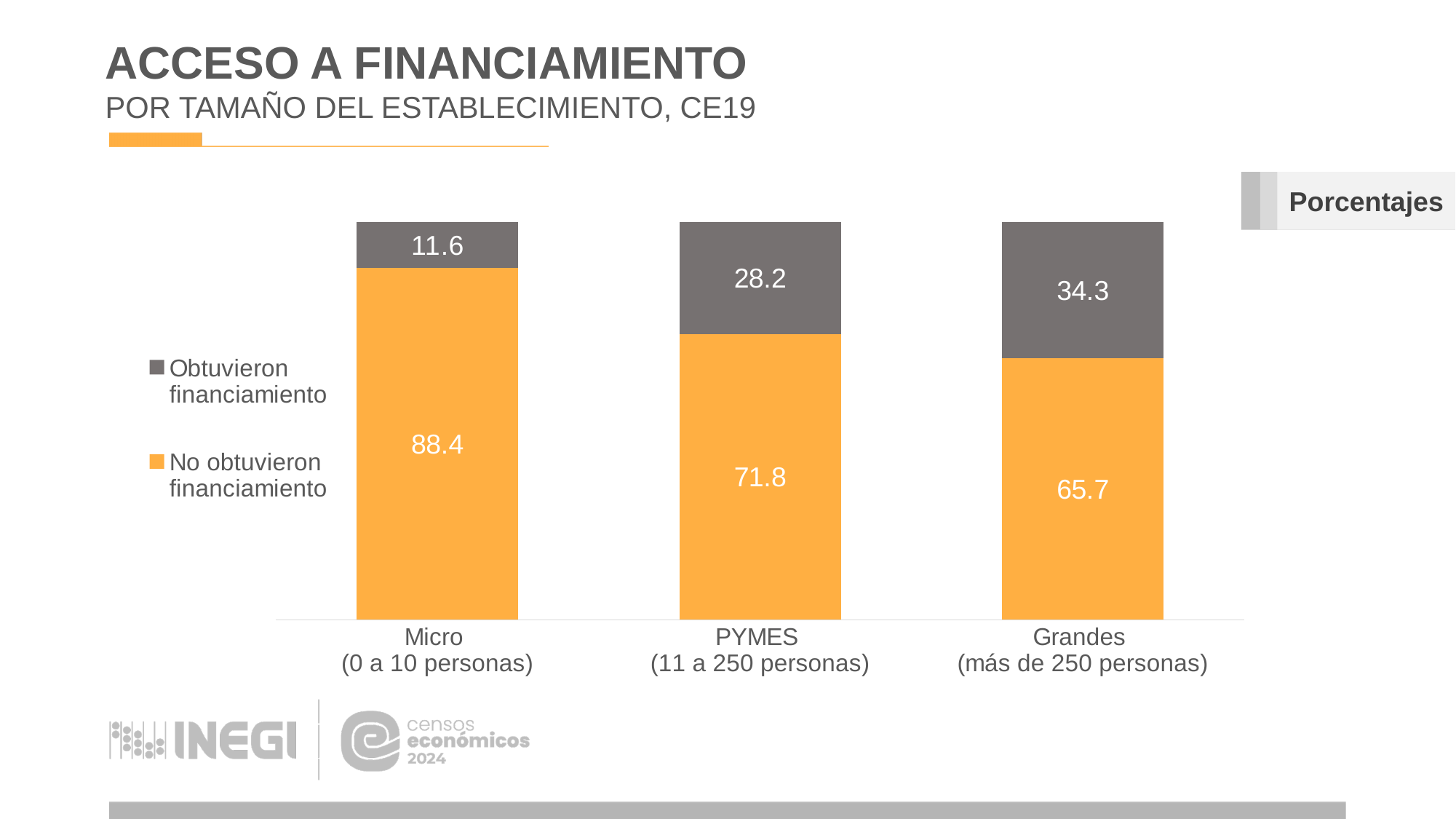
Do the 'Obtuvieron financiamiento' values rise or fall from Micro to Grandes along the x axis? Rise Which establishment size has the highest value for 'Obtuvieron financiamiento'? Grandes (más de 250 personas) What kind of chart is shown on the slide? Stacked bar chart What is the difference between the 'Obtuvieron financiamiento' values for Grandes and Micro? 22.7 Which is larger: the 'No obtuvieron financiamiento' value for Micro or for PYMES? Micro What is the total of the stacked bar for PYMES (11 a 250 personas)? 100 What is the value for 'No obtuvieron financiamiento' for PYMES (11 a 250 personas)? 71.8 How many establishment size categories are shown on the x axis? 3 Which establishment size has the lowest value for 'No obtuvieron financiamiento'? Grandes (más de 250 personas) What is the value for 'Obtuvieron financiamiento' for Grandes (más de 250 personas)? 34.3 How many series does the legend list? 2 What is the value for 'Obtuvieron financiamiento' for Micro (0 a 10 personas)? 11.6